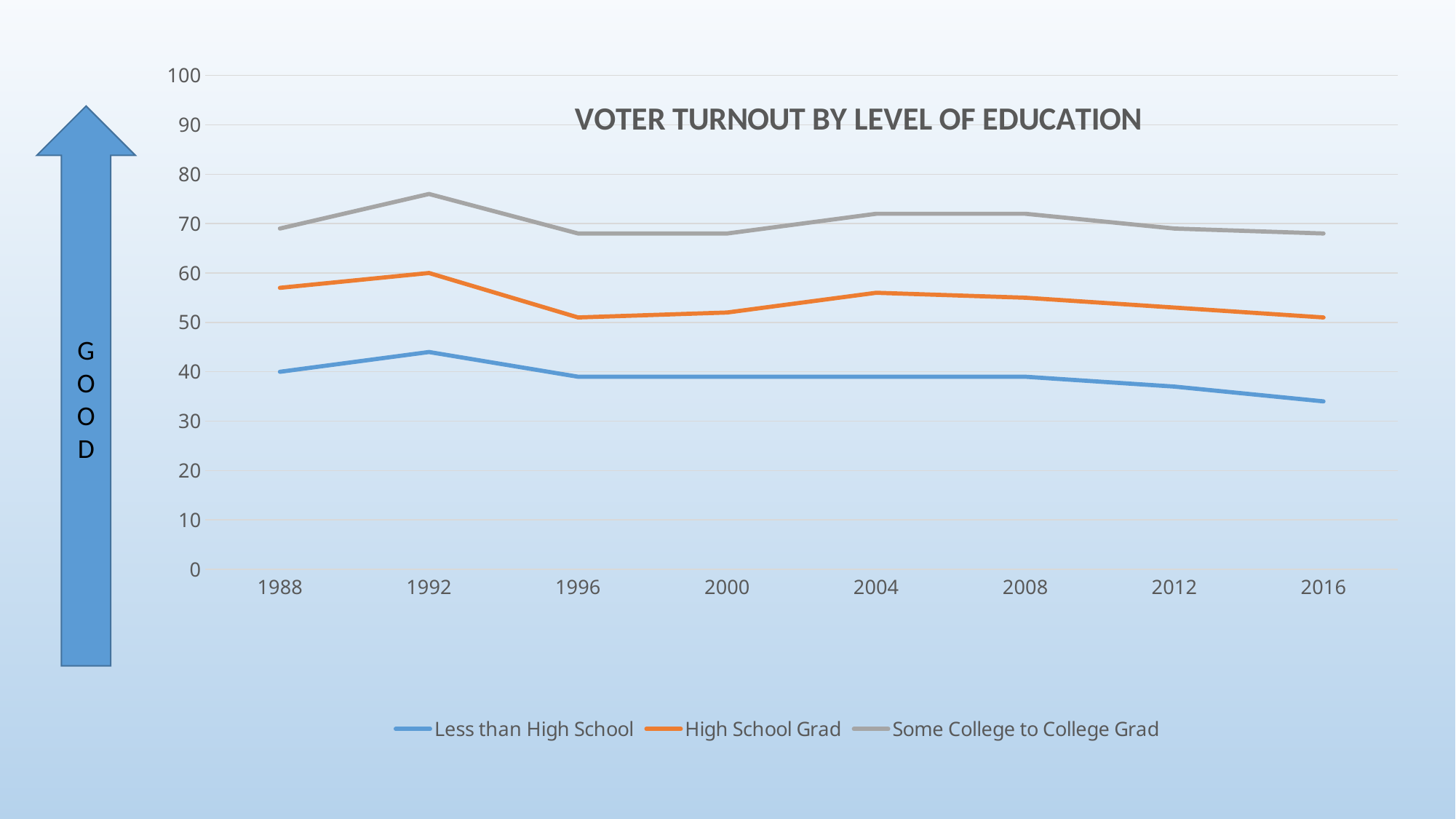
In which year does the High School Grad series reach its highest value? 1992 How many series does the legend list? 3 Is the value for High School Grad in 1996 greater or less than 60? less What is the title of the chart? VOTER TURNOUT BY LEVEL OF EDUCATION Is the value for Some College to College Grad in 1992 greater or less than 70? greater Is the value for Less than High School in 2016 greater or less than 40? less How many years are plotted along the x axis? 8 In which year does the Some College to College Grad series reach its highest value? 1992 Which series has the higher value in 2004, High School Grad or Less than High School? High School Grad What kind of chart is shown on the slide? line chart In which year does the Less than High School series reach its lowest value? 2016 Does the Less than High School series rise or fall from 2008 to 2016? fall